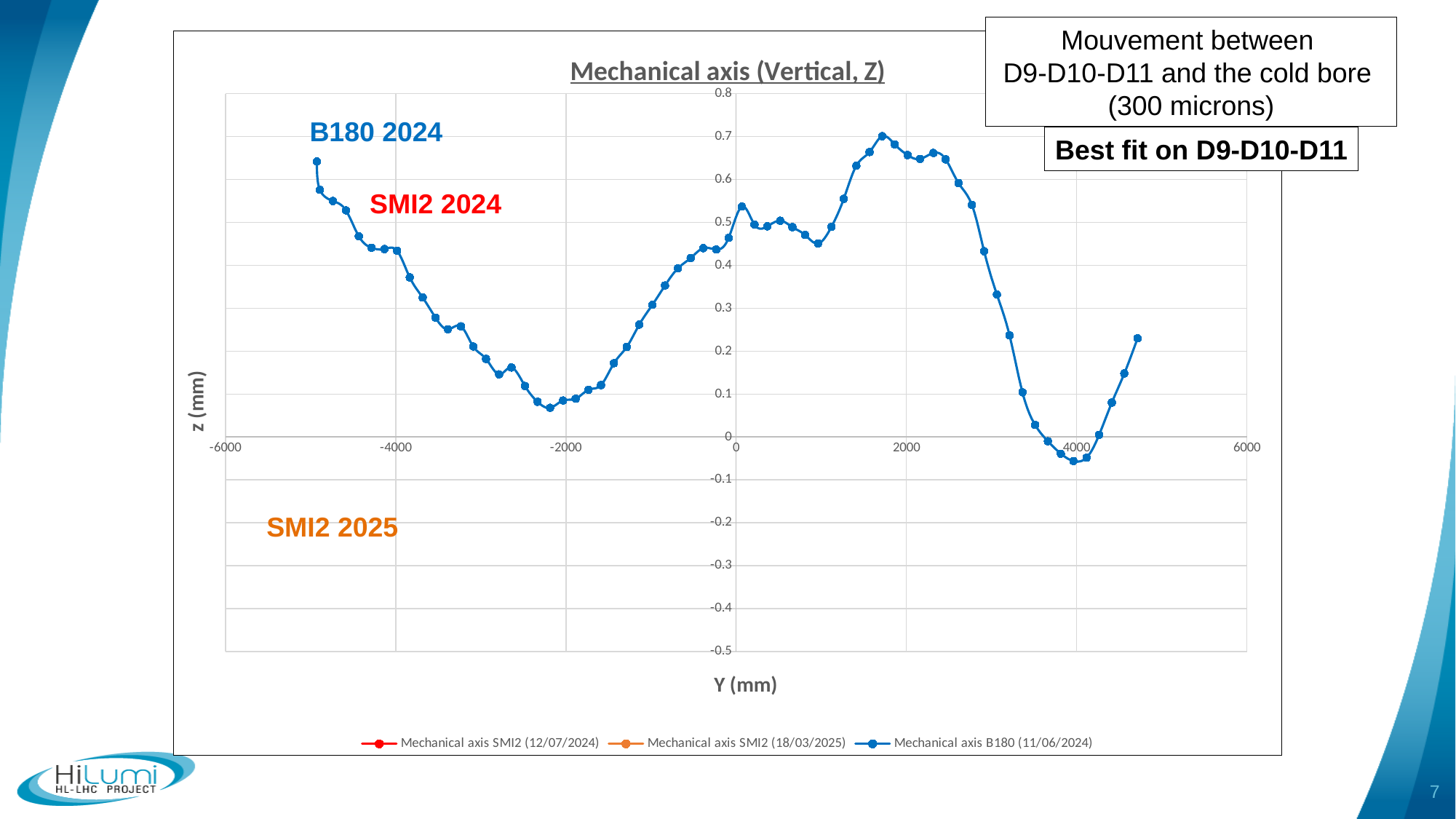
Is the value of the Mechanical axis B180 (11/06/2024) series at Y = 0 greater or less than 0.4? greater Is the value of the Mechanical axis B180 (11/06/2024) series at Y = 4000 greater or less than 0? less What is the label of the horizontal axis of the chart? Y (mm) Is the value of the Mechanical axis B180 (11/06/2024) series at Y = -4000 greater or less than 0.4? greater What is the title of the chart? Mechanical axis (Vertical, Z) What kind of chart is shown on the slide? line chart Which is larger for the Mechanical axis B180 (11/06/2024) series: the value at Y = 2000 or the value at Y = -2000? Y = 2000 How many series does the legend of the chart list? 3 Do the values of the Mechanical axis B180 (11/06/2024) series rise or fall between Y = 2000 and Y = 4000? fall